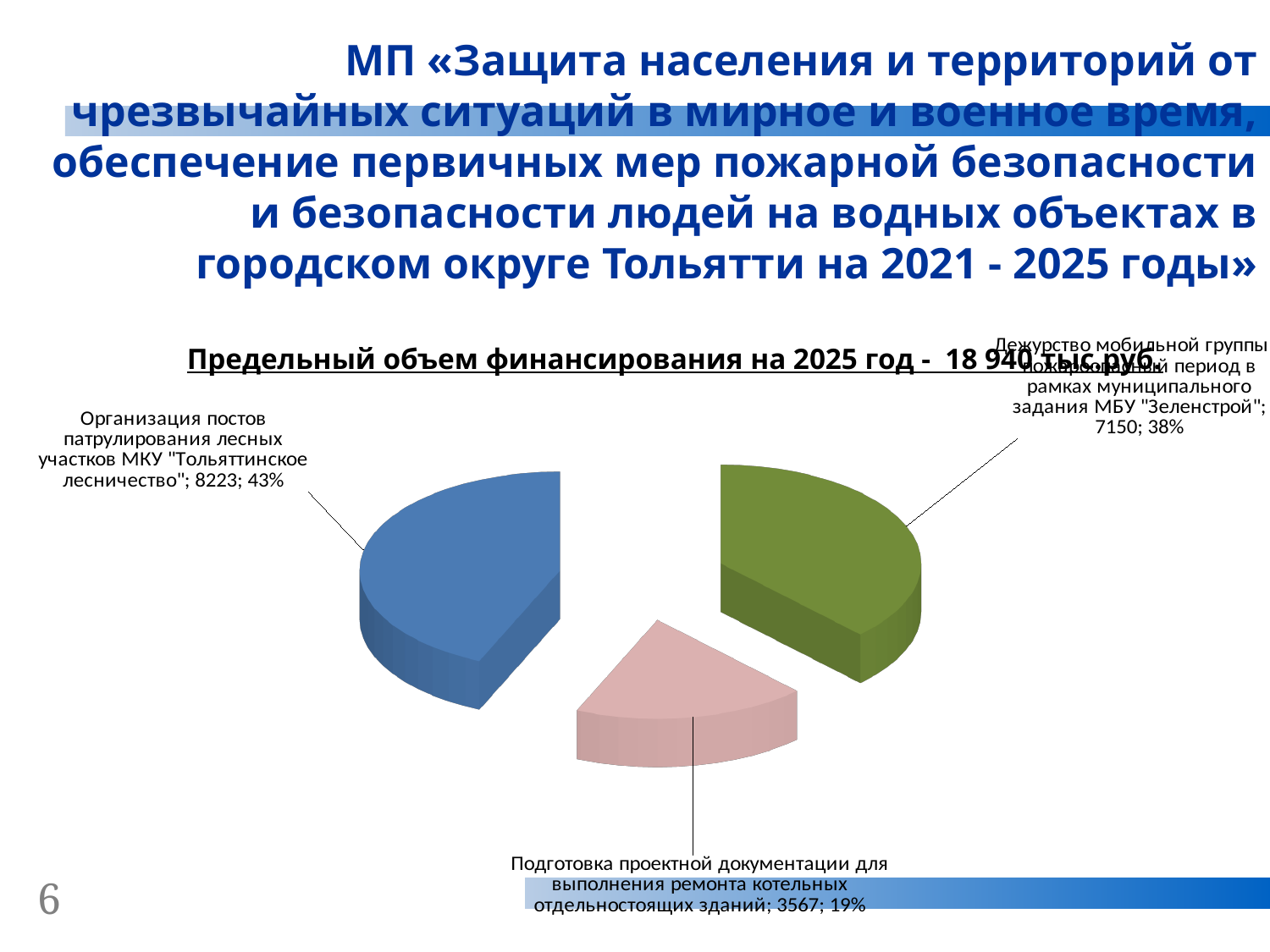
Which slice of the pie chart is the largest? Организация постов патрулирования лесных участков МКУ "Тольяттинское лесничество" What share of the pie does "Организация постов патрулирования лесных участков МКУ "Тольяттинское лесничество"" represent? 43% What is the value for "Организация постов патрулирования лесных участков МКУ "Тольяттинское лесничество""? 8223 Which slice of the pie chart is the smallest? Подготовка проектной документации для выполнения ремонта котельных отдельностоящих зданий What is the value for "Подготовка проектной документации для выполнения ремонта котельных отдельностоящих зданий"? 3567 Which is larger: the value for the МБУ "Зеленстрой" slice or the value for "Подготовка проектной документации для выполнения ремонта котельных отдельностоящих зданий"? МБУ "Зеленстрой" slice What is the difference between the value for "Организация постов патрулирования лесных участков МКУ "Тольяттинское лесничество"" and the value for "Подготовка проектной документации для выполнения ремонта котельных отдельностоящих зданий"? 4656 What share of the pie does "Подготовка проектной документации для выполнения ремонта котельных отдельностоящих зданий" represent? 19% What total funding amount for 2025 is stated in the chart title? 18 940 тыс.руб. How many slices does the pie chart have? 3 What is the value for the slice related to МБУ "Зеленстрой"? 7150 What kind of chart is shown on the slide? pie chart